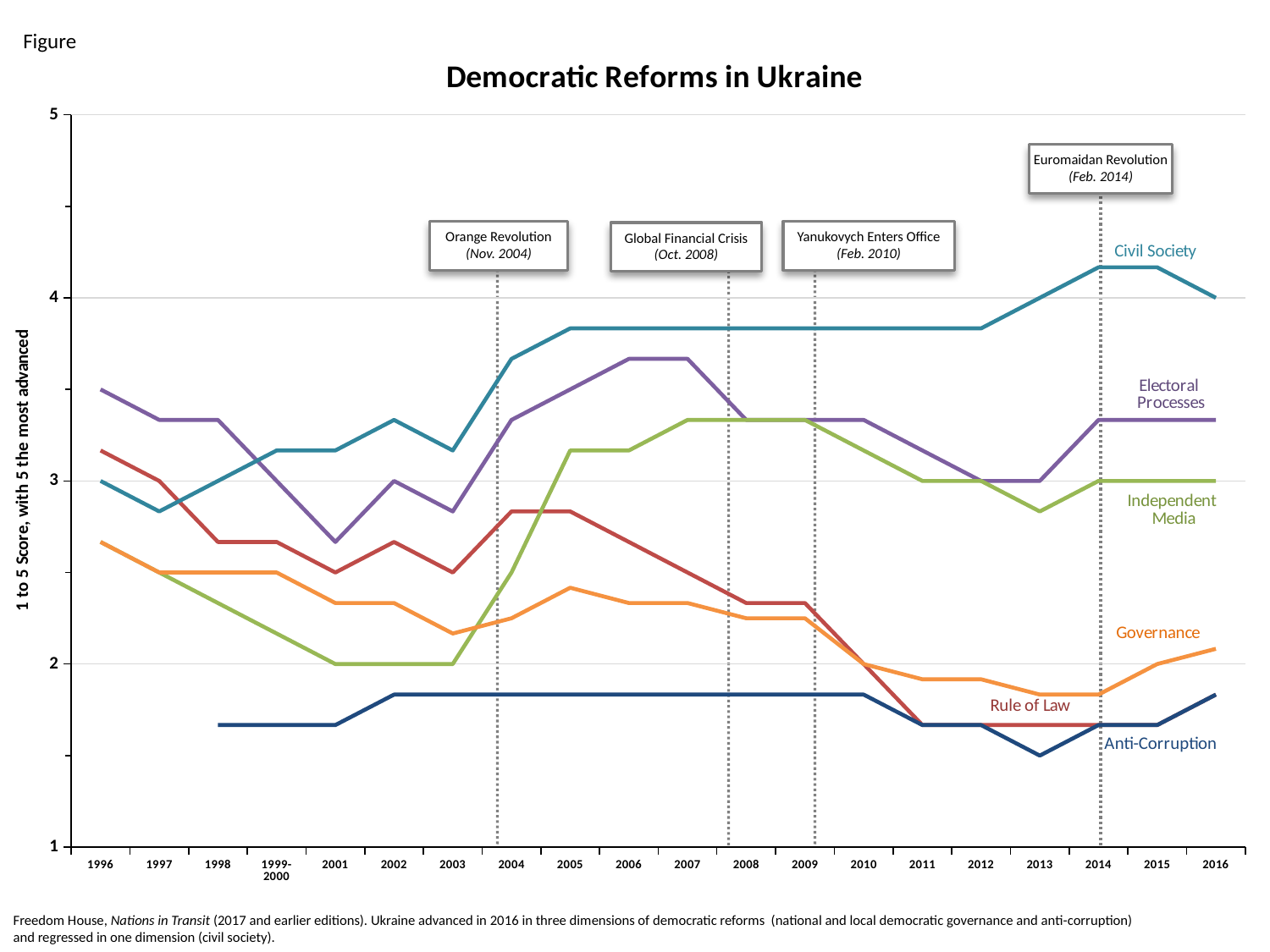
What is the Independent Media score in 2001? 2 Is the Anti-Corruption value in 2013 greater or less than 2? less What is the Civil Society score in 2016? 4 How many series are labelled on the chart? 6 Which series has the lowest score in 2013? Anti-Corruption Is the Civil Society value in 2014 greater or less than 4? greater How many categories are shown on the x axis? 20 Does the Civil Society line rise or fall between 2012 and 2014? rise What is the title of the chart? Democratic Reforms in Ukraine In 2010, which is larger: the Civil Society score or the Governance score? Civil Society Which series has the highest score in 2016? Civil Society What type of chart is shown on the slide? line chart